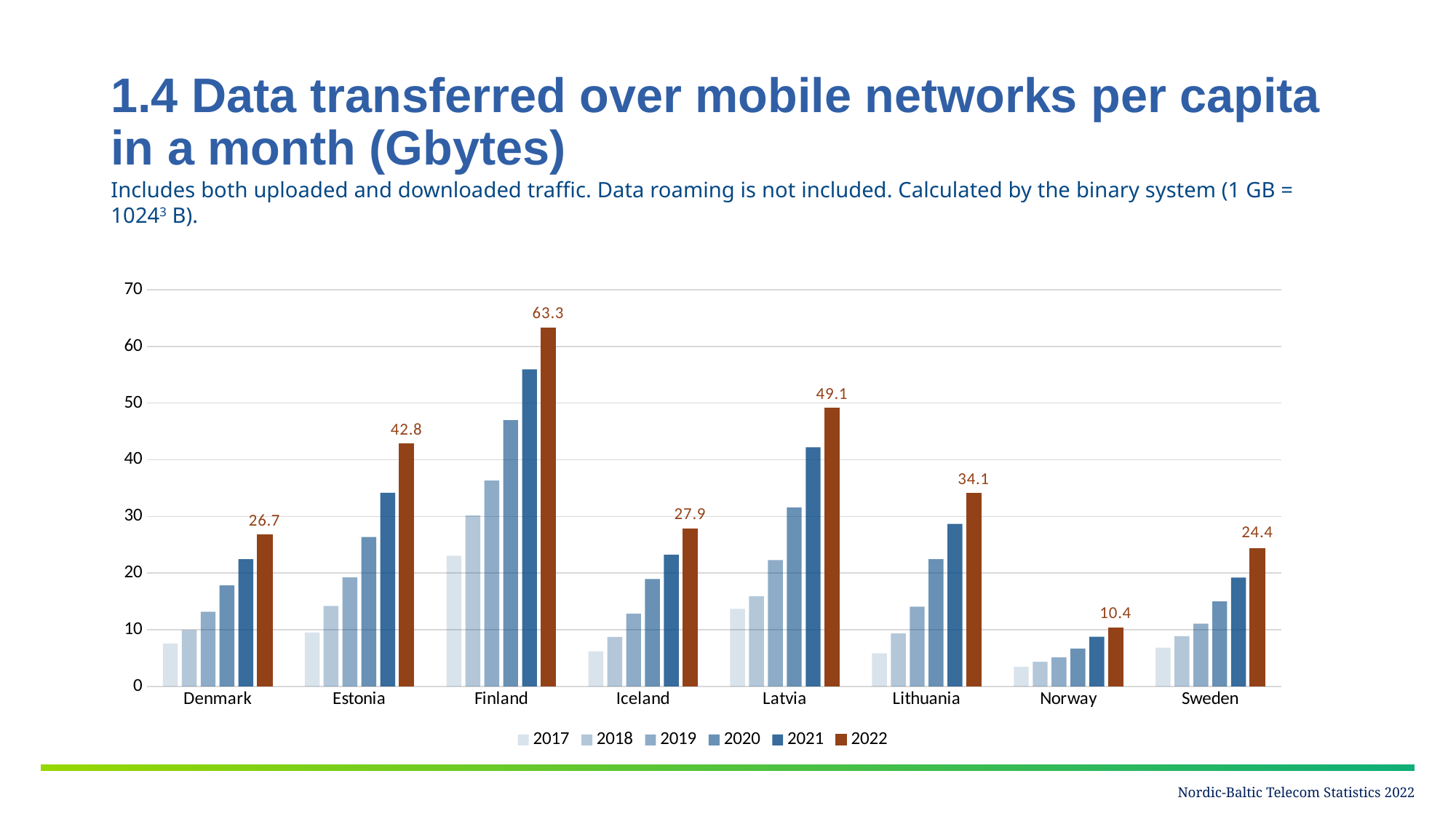
Is the 2021 value for Finland greater or less than 50? greater What is the 2022 value for Finland? 63.3 Which country has the highest 2022 value? Finland How many countries are shown on the x axis? 8 Which country has the lowest 2022 value? Norway Which has a larger 2022 value, Iceland or Sweden? Iceland What is the 2022 value for Norway? 10.4 What is the difference between the 2022 values for Estonia and Denmark? 16.1 What is the 2022 value for Latvia? 49.1 How many series does the legend list? 6 What kind of chart is shown on the slide? Bar chart Is the 2017 value for Denmark greater or less than 10? less